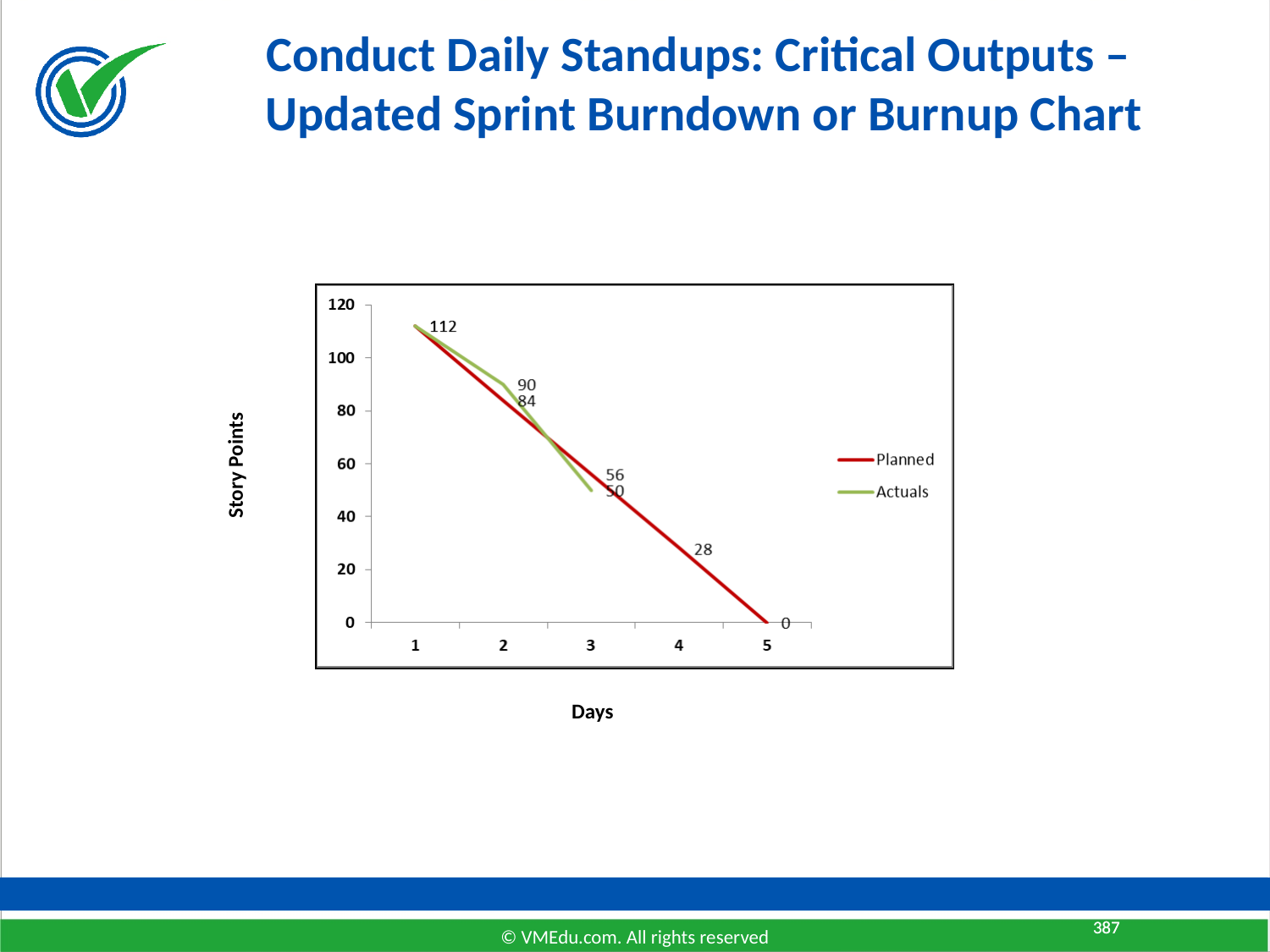
How many days are shown on the x axis? 5 What is the Planned value of story points on day 4? 28 What is the label of the y axis? Story Points How many series does the legend list? 2 Do the Planned values rise or fall as the days increase? fall What is the Actuals value of story points on day 3? 50 What is the Planned value of story points on day 5? 0 What kind of chart is shown on the slide? line chart On day 2, which series has the larger value, Planned or Actuals? Actuals What is the difference between the Actuals and Planned values on day 3? 6 What is the Planned value of story points on day 2? 84 What is the Actuals value of story points on day 2? 90